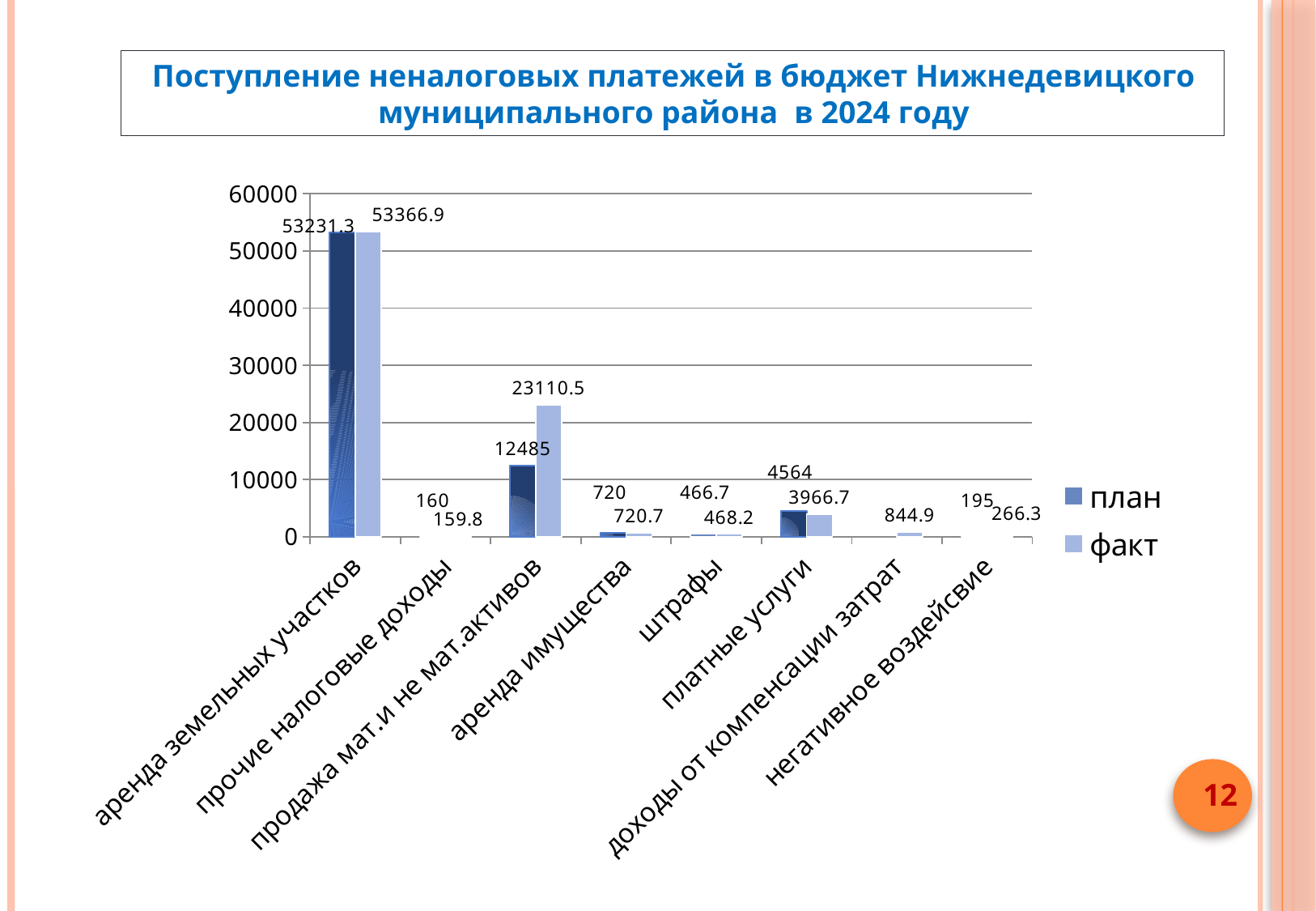
What kind of chart is shown on the slide? bar chart Which category has the highest факт value? аренда земельных участков What is the план value for продажа мат.и не мат.активов? 12485 How many categories are shown on the x axis? 8 How many series does the legend list? 2 What is the факт value for платные услуги? 3966.7 What is the план value for негативное воздействие? 195 For платные услуги, which is larger: план or факт? план Is the факт value for продажа мат.и не мат.активов greater or less than 20000? greater What is the факт value for аренда земельных участков? 53366.9 Which category has the lowest план value among those with a план label? прочие налоговые доходы What is the difference between the факт and план values for продажа мат.и не мат.активов? 10625.5